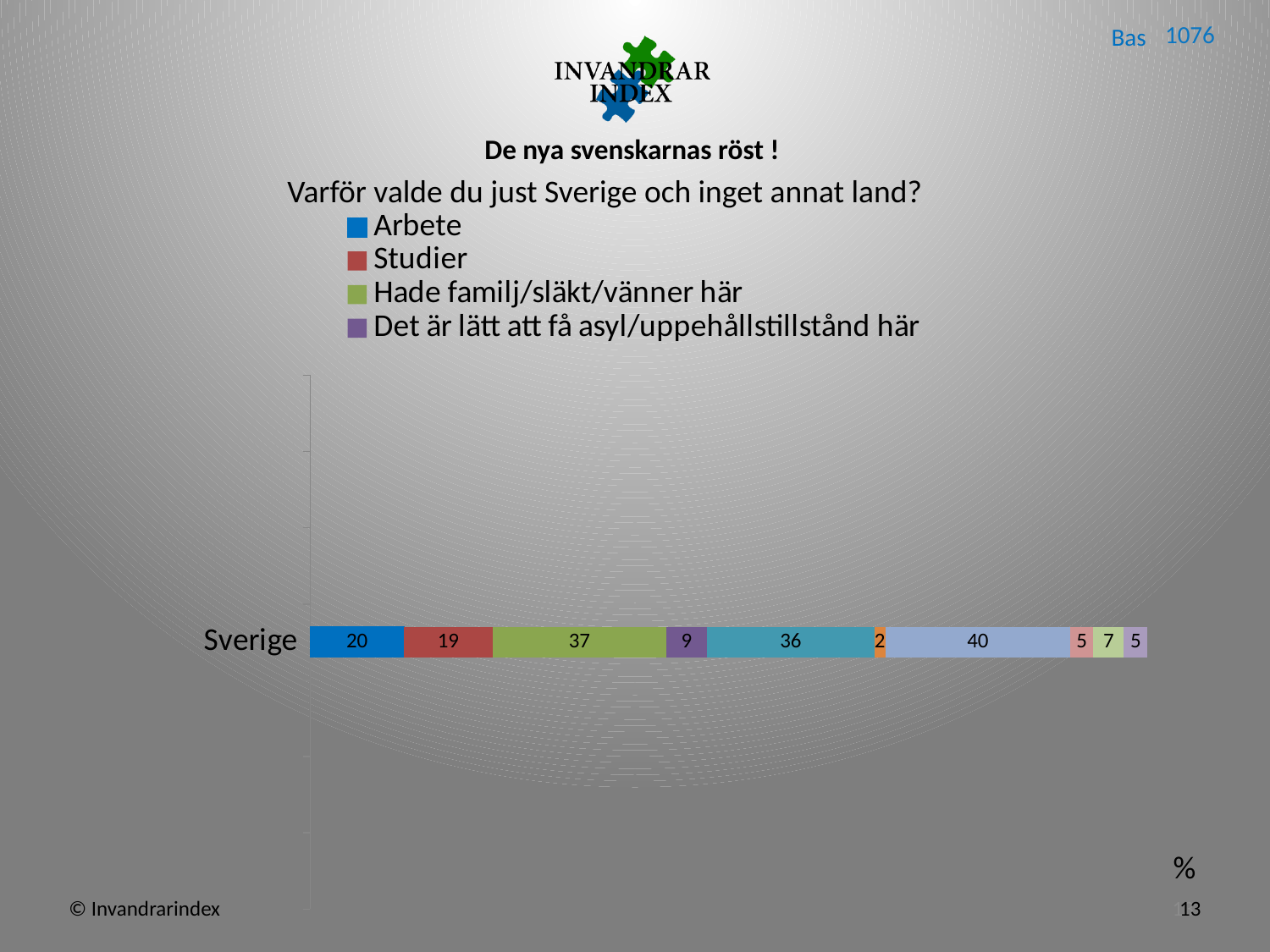
Which of the four series listed in the legend has the lowest value? Det är lätt att få asyl/uppehållstillstånd här What is the value for Arbete in the Sverige bar? 20 Which is larger, the value for Arbete or the value for Studier? Arbete Which of the four series listed in the legend has the highest value? Hade familj/släkt/vänner här What is the value for Hade familj/släkt/vänner här? 37 How many series does the legend list? 4 What is the total of all segments in the Sverige stacked bar? 180 What kind of chart is shown on the slide? Stacked bar chart What is the value for Studier in the Sverige bar? 19 What is the value for Det är lätt att få asyl/uppehållstillstånd här? 9 What is the difference between the values for Hade familj/släkt/vänner här and Det är lätt att få asyl/uppehållstillstånd här? 28 How many categories are shown on the vertical axis of the chart? 1